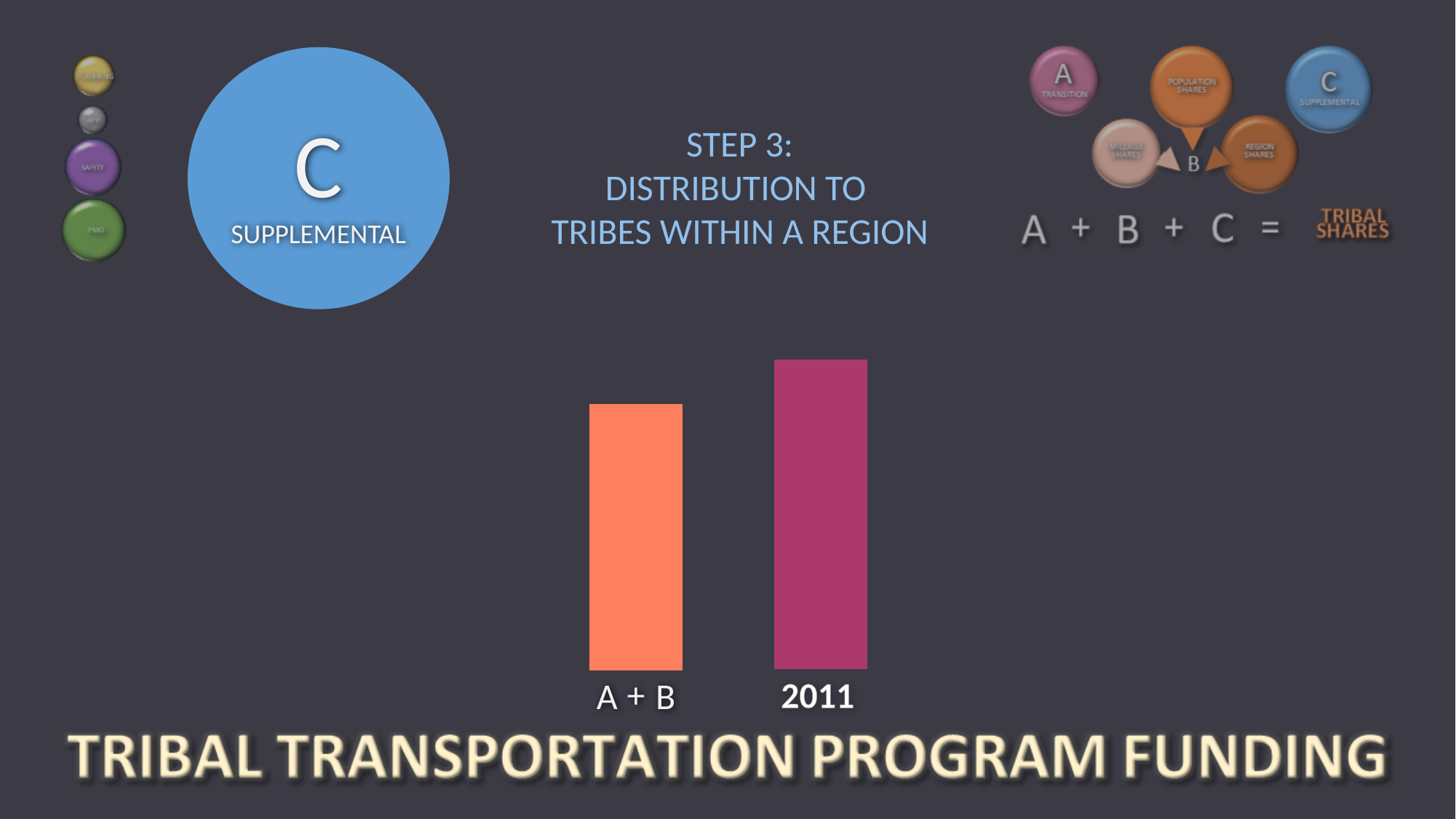
What kind of chart is shown on the slide? bar chart Is the bar for A + B shorter or taller than the bar for 2011? shorter What are the category labels shown under the bars? A + B and 2011 Which bar is taller, A + B or 2011? 2011 What colour is the bar for 2011? magenta How many bars does the chart show? 2 Which category has the shortest bar? A + B Which category has the tallest bar? 2011